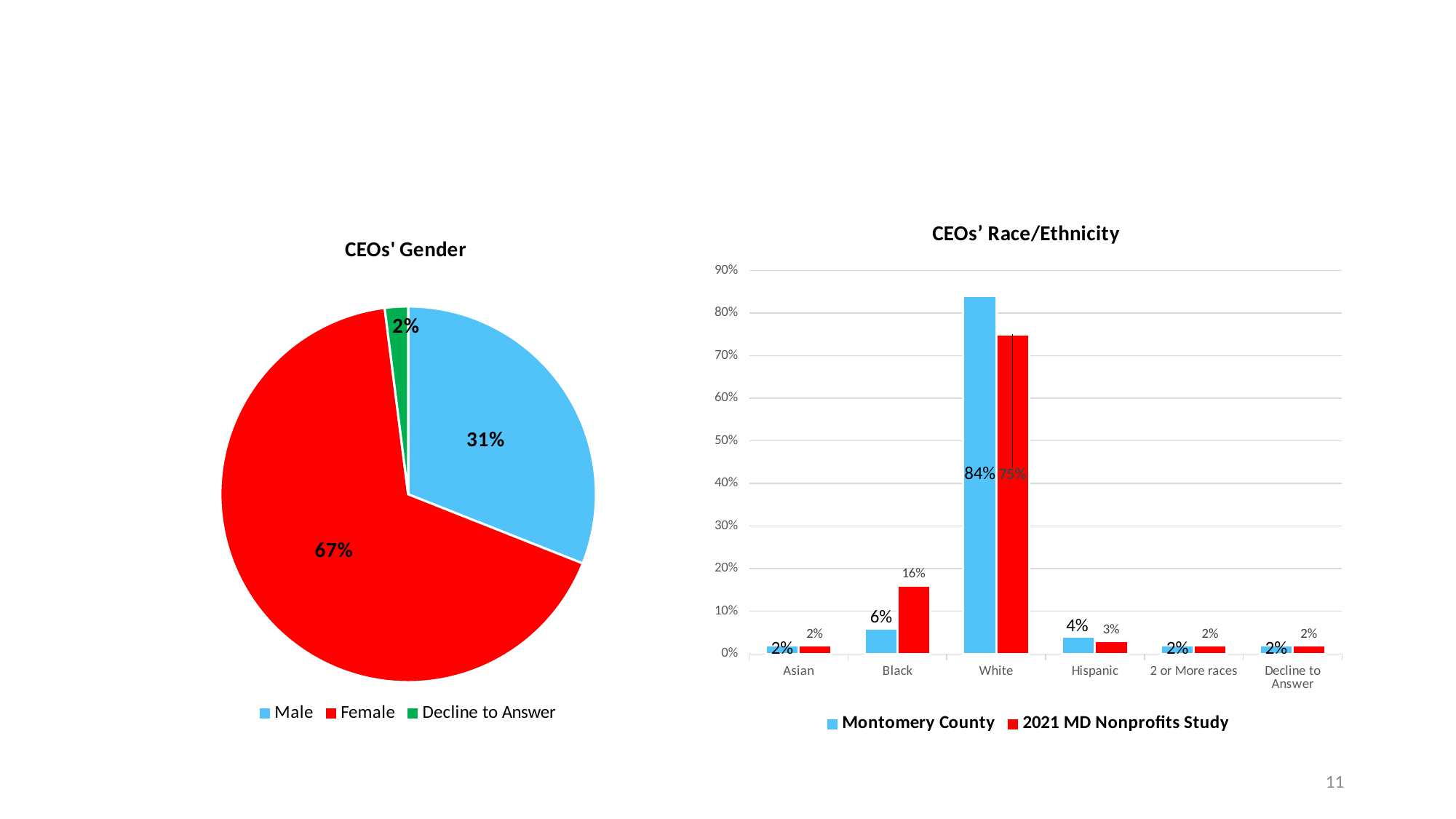
What kind of chart is the CEOs' Gender chart? pie chart In the CEOs' Gender pie chart, how many categories does the legend list? 3 In the CEOs' Gender pie chart, which category has the smallest slice? Decline to Answer In the CEOs' Gender pie chart, what share of CEOs are male? 31% In the CEOs' Race/Ethnicity chart, what is the Montomery County value for White? 84% In the CEOs' Race/Ethnicity chart, what is the difference between the Montomery County and 2021 MD Nonprofits Study values for White? 9% What kind of chart is the CEOs' Race/Ethnicity chart? bar chart In the CEOs' Race/Ethnicity chart, what is the 2021 MD Nonprofits Study value for Black? 16% In the CEOs' Race/Ethnicity chart, which is larger for Black: Montomery County or 2021 MD Nonprofits Study? 2021 MD Nonprofits Study In the CEOs' Race/Ethnicity chart, which category has the highest Montomery County value? White In the CEOs' Gender pie chart, what share of CEOs are female? 67% In the CEOs' Race/Ethnicity chart, how many series does the legend list? 2